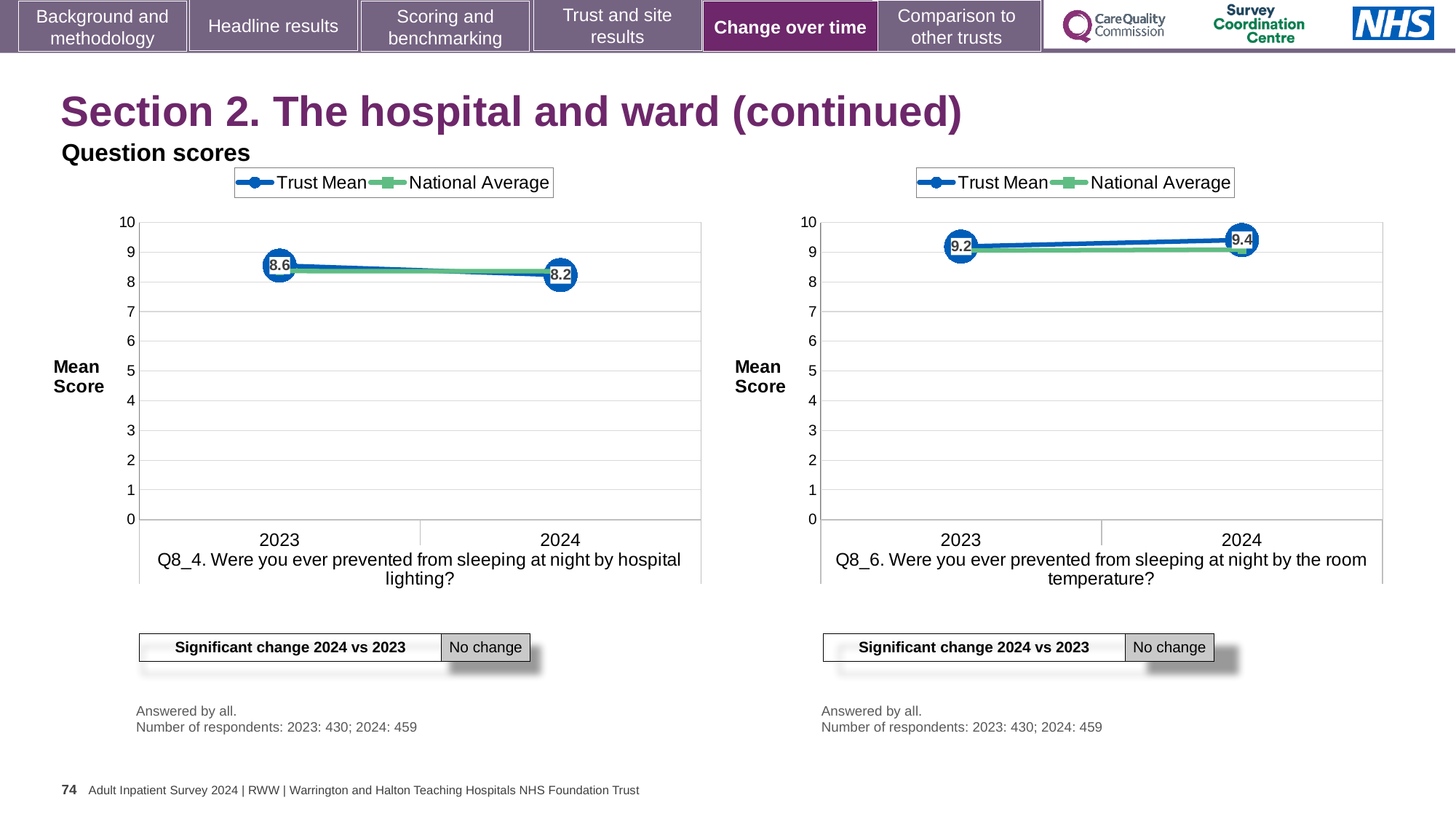
In the Q8_6 room temperature chart, what is the Trust Mean for 2023? 9.2 In the Q8_4 hospital lighting chart, by how much did the Trust Mean change from 2023 to 2024? 0.4 In the Q8_4 hospital lighting chart, what is the Trust Mean for 2024? 8.2 In the Q8_4 hospital lighting chart, is the Trust Mean for 2024 greater or less than 9? less In the Q8_6 room temperature chart, what is the Trust Mean for 2024? 9.4 In the Q8_6 room temperature chart, which year has the higher Trust Mean, 2023 or 2024? 2024 What type of chart is used for the Q8_4 hospital lighting question? line chart How many series does the legend of the Q8_6 room temperature chart list? 2 In the Q8_6 room temperature chart, does the Trust Mean rise or fall from 2023 to 2024? rise In the Q8_6 room temperature chart, what is the difference between the Trust Mean in 2024 and 2023? 0.2 In the Q8_4 hospital lighting chart, what is the Trust Mean for 2023? 8.6 In the Q8_4 hospital lighting chart, does the Trust Mean rise or fall from 2023 to 2024? fall